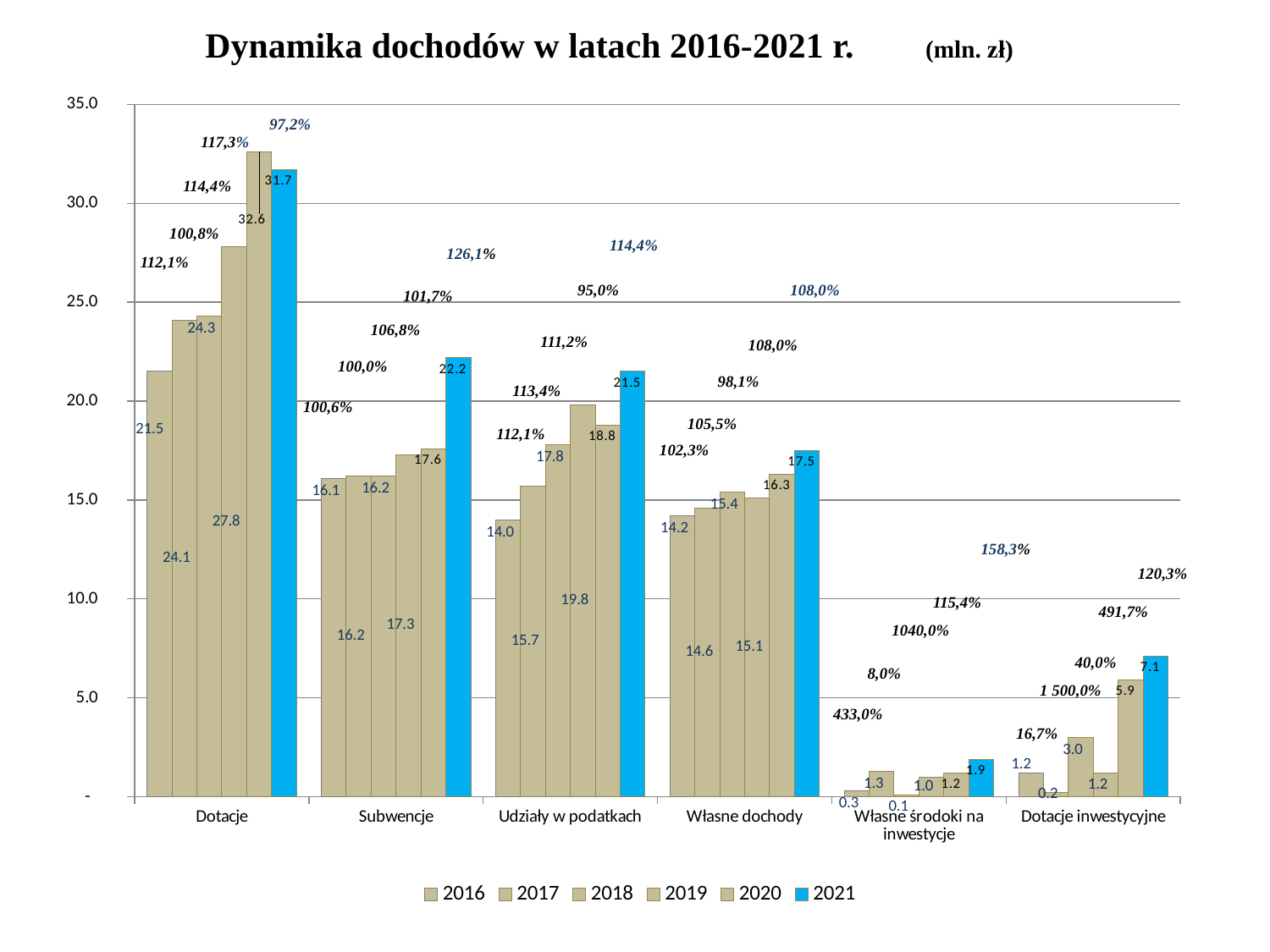
What is the difference between the Dotacje values for 2021 and 2016? 10.2 How many series does the legend list? 6 Which year has the highest value for Dotacje? 2020 Which year has the lowest value for Własne środoki na inwestycje? 2018 What type of chart is shown on the slide? bar chart What is the value for Subwencje in 2021? 22.2 What is the value for Dotacje in 2021? 31.7 How many categories are shown on the x axis? 6 What is the title of the chart? Dynamika dochodów w latach 2016-2021 r. Which is larger in 2021: Udziały w podatkach or Własne dochody? Udziały w podatkach What is the value for Dotacje inwestycyjne in 2021? 7.1 Do the Subwencje values rise or fall from 2016 to 2021? rise